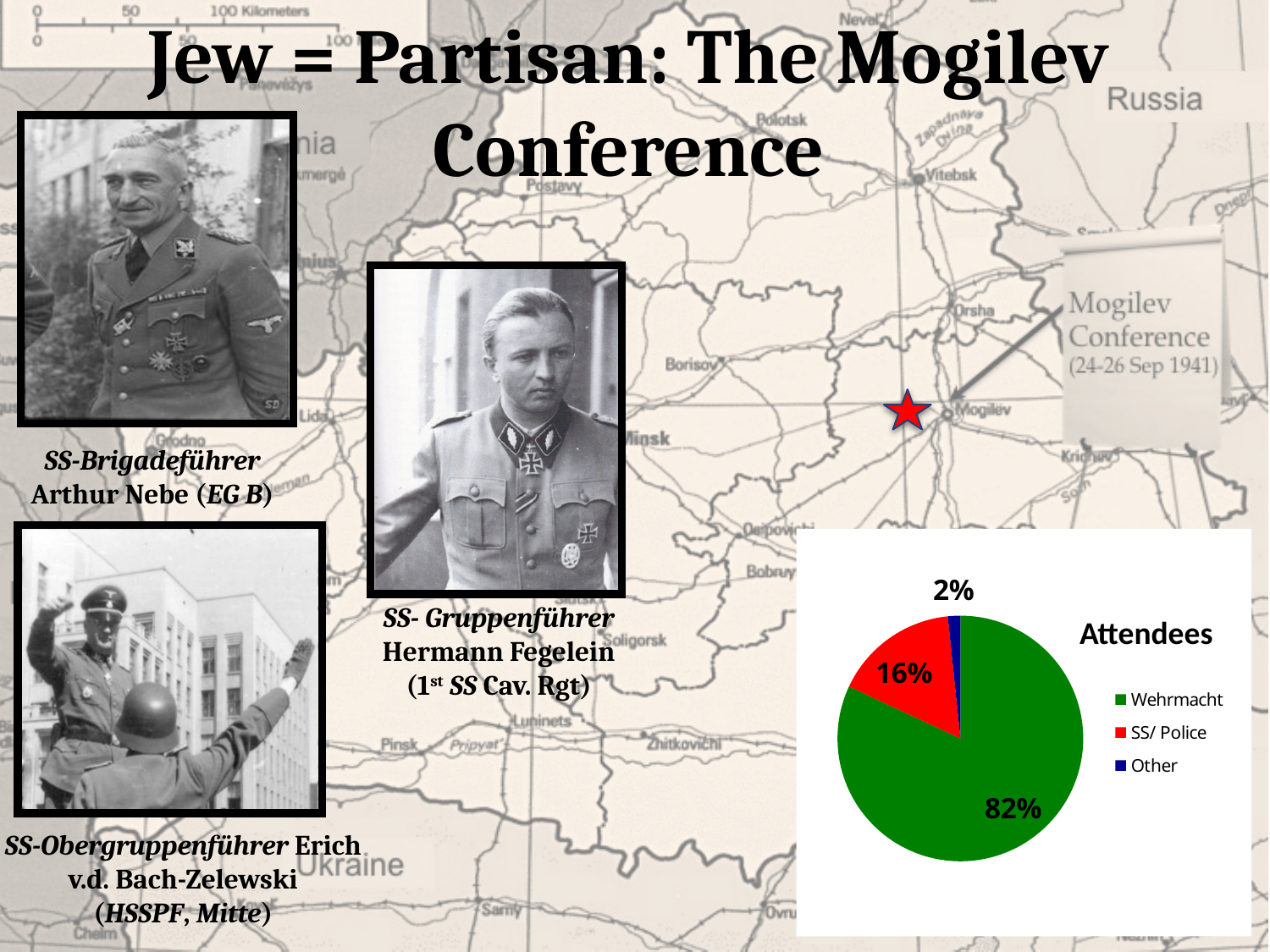
What is the title of the chart? Attendees What share of attendees does the Other slice represent? 2% What colour is the Wehrmacht slice in the pie chart? green Which is larger, the SS/ Police share or the Other share? SS/ Police Which category has the smallest share of attendees? Other Which category has the largest share of attendees? Wehrmacht What share of attendees does the Wehrmacht slice represent? 82% What is the difference in percentage points between the SS/ Police and Other shares? 14 How many categories does the pie chart show? 3 What share of attendees does the SS/ Police slice represent? 16% What is the difference in percentage points between the Wehrmacht and SS/ Police shares? 66 What kind of chart is shown on the slide? pie chart